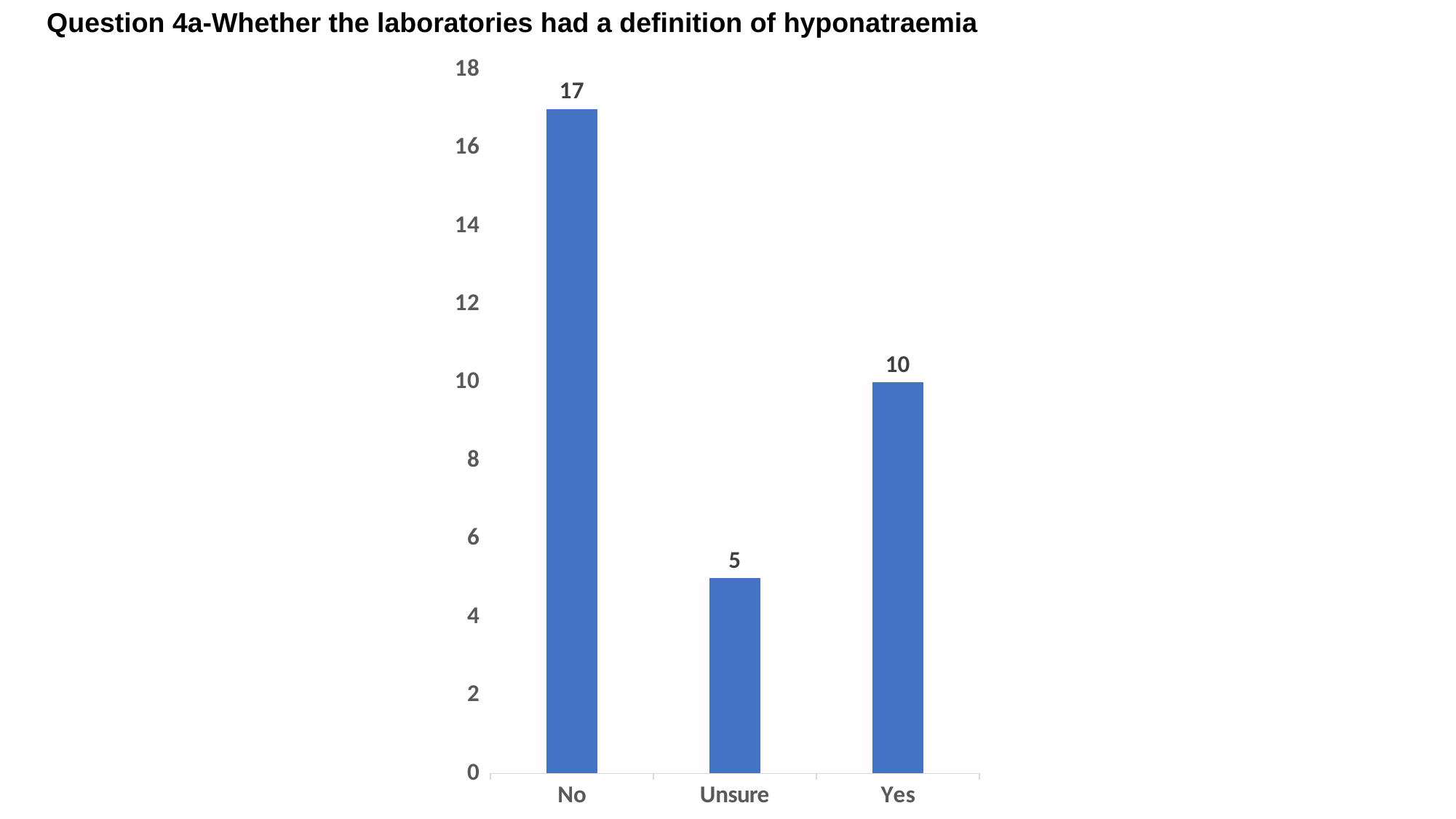
Which is larger, the value for Yes or the value for Unsure? Yes Which category has the highest value? No Which category has the lowest value? Unsure What is the title of the chart? Question 4a-Whether the laboratories had a definition of hyponatraemia Is the value for No greater or less than 16? greater What is the value for Yes? 10 What is the difference between the values for Yes and Unsure? 5 What is the value for No? 17 What is the value for Unsure? 5 What is the difference between the values for No and Yes? 7 How many categories are shown on the x axis? 3 What kind of chart is shown on the slide? bar chart